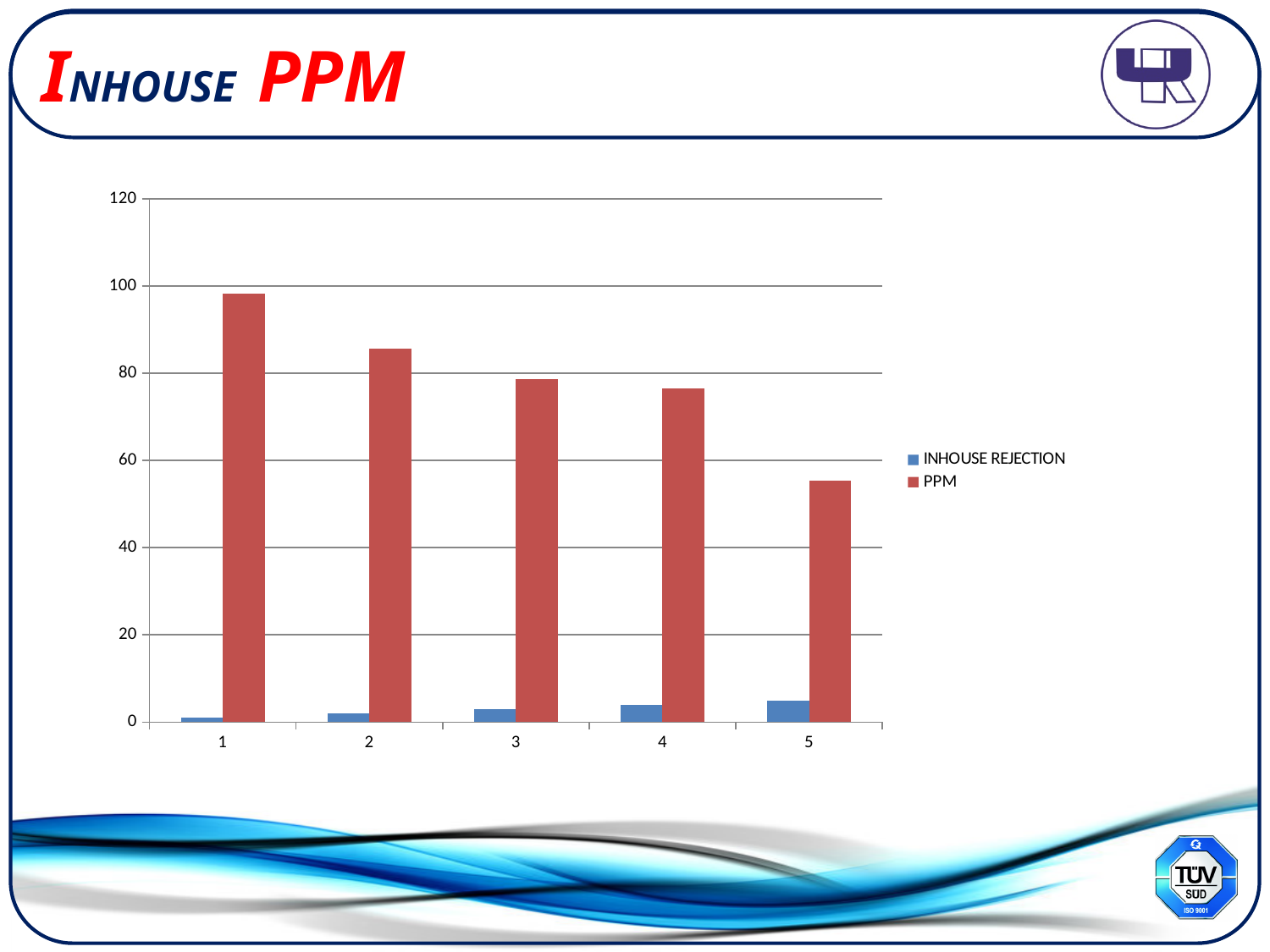
Is the PPM value for category 3 greater or less than 100? less Which category has the lowest PPM value? 5 Do the INHOUSE REJECTION values rise or fall from category 1 to category 5? rise How many categories are shown on the x axis? 5 Do the PPM values rise or fall from category 1 to category 5? fall Which is larger, the PPM value for category 2 or the PPM value for category 5? category 2 What colour are the PPM bars? red Is the PPM value for category 1 greater or less than 80? greater How many series does the legend list? 2 What kind of chart is shown on the slide? bar chart Is the PPM value for category 5 greater or less than 60? less Which category has the highest PPM value? 1